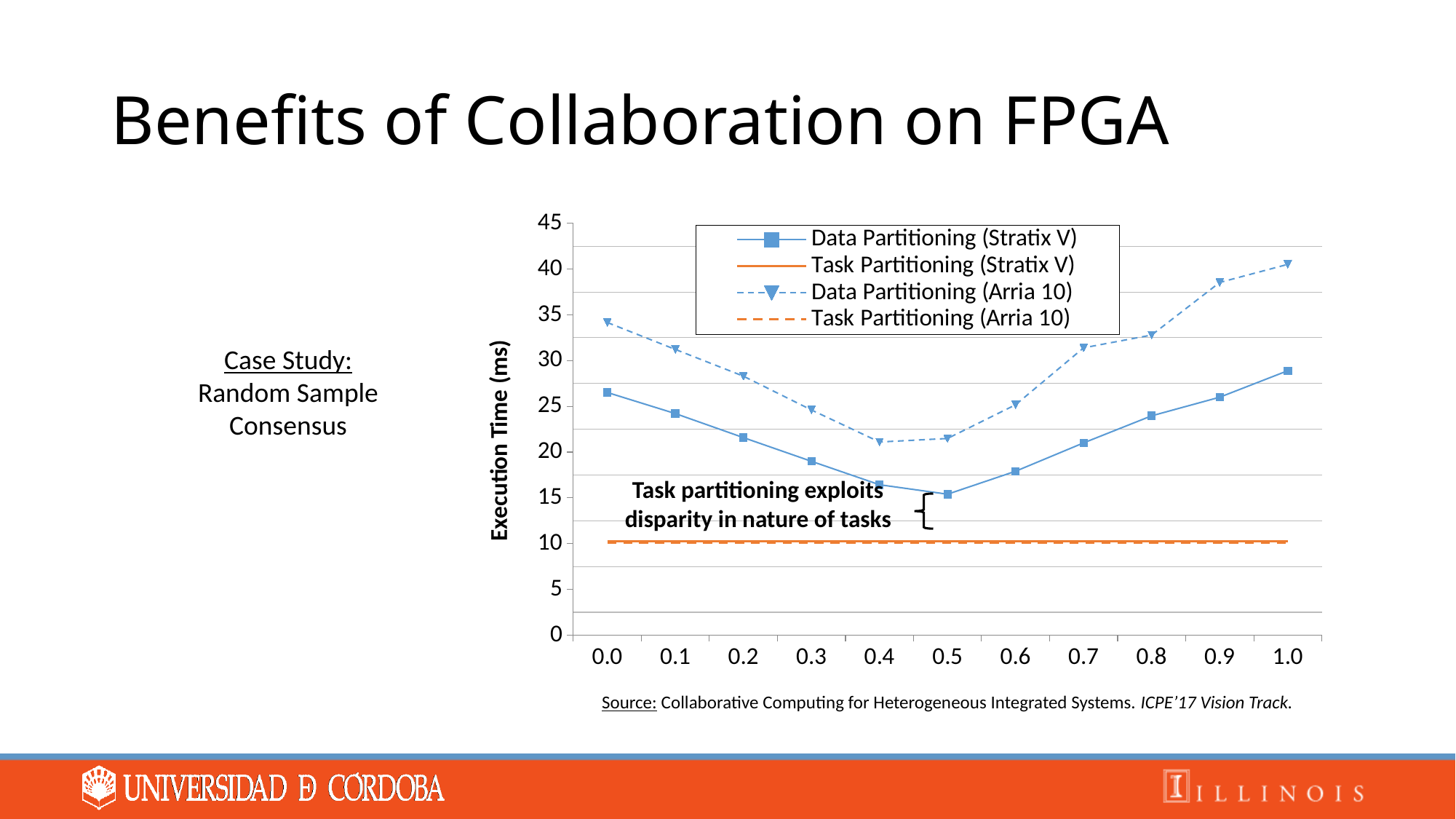
Does the Data Partitioning (Stratix V) line rise or fall from 0.5 to 1.0? rise How many x-axis points are plotted for each series? 11 Is the value for Data Partitioning (Arria 10) at 1.0 greater or less than 35? greater At which x value does Data Partitioning (Arria 10) reach its highest execution time? 1.0 At 0.0, which series has the higher execution time: Data Partitioning (Arria 10) or Data Partitioning (Stratix V)? Data Partitioning (Arria 10) Is the value for Data Partitioning (Stratix V) at 0.5 greater or less than 20? less Which series is drawn with a dashed orange line? Task Partitioning (Arria 10) What kind of chart is shown on the slide? Line chart How many series does the legend list? 4 Is the value for Data Partitioning (Stratix V) at 0.0 greater or less than 25? greater What is the label of the y axis? Execution Time (ms) At which x value does Data Partitioning (Stratix V) reach its lowest execution time? 0.5